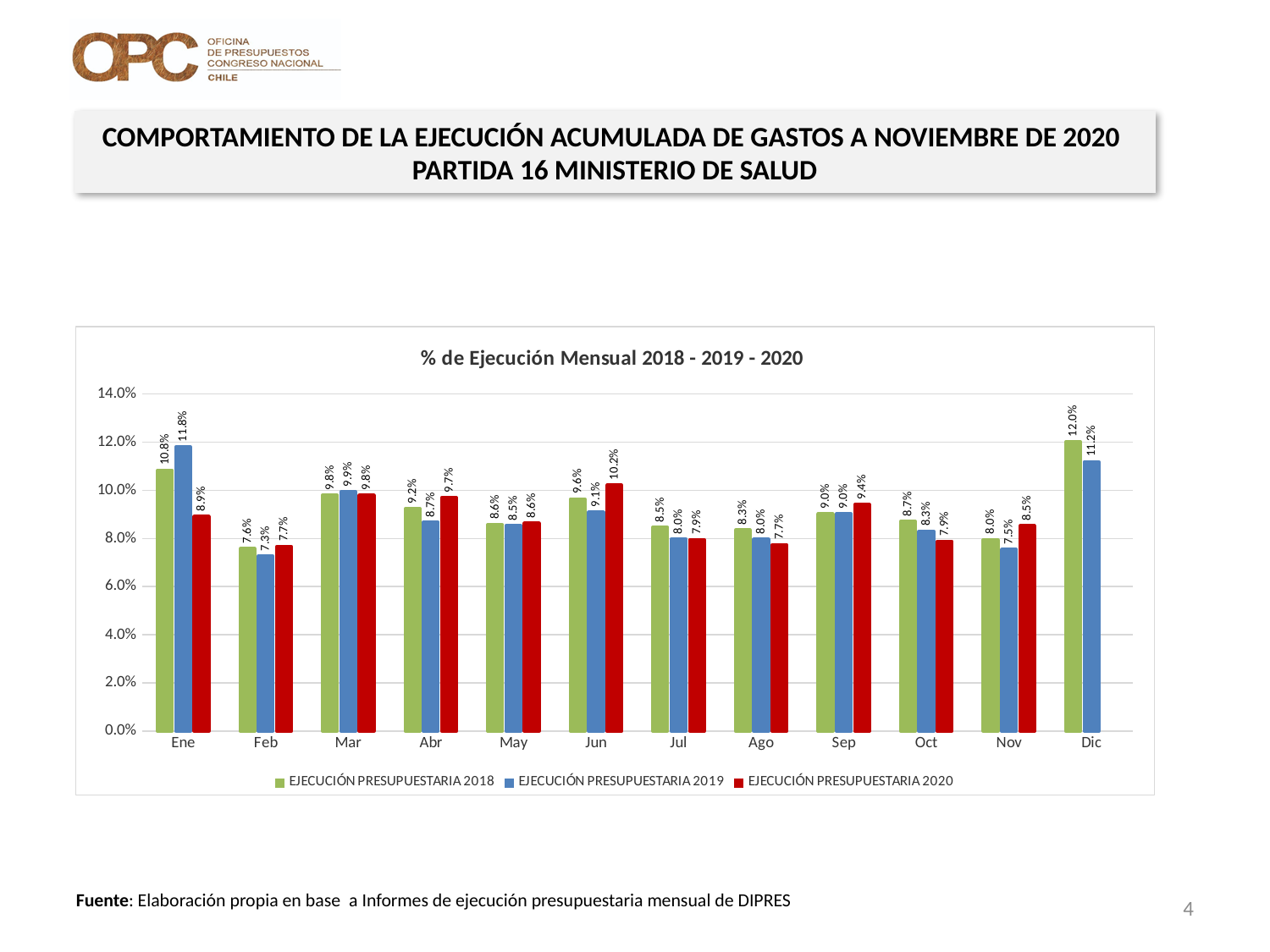
What is the title of the chart? % de Ejecución Mensual 2018 - 2019 - 2020 Which month has the lowest value for EJECUCIÓN PRESUPUESTARIA 2019? Feb What is the value for EJECUCIÓN PRESUPUESTARIA 2018 in Dic? 12.0% What is the value for EJECUCIÓN PRESUPUESTARIA 2019 in Ene? 11.8% Which is larger in Nov: EJECUCIÓN PRESUPUESTARIA 2018 or EJECUCIÓN PRESUPUESTARIA 2020? EJECUCIÓN PRESUPUESTARIA 2020 Which month has the highest value for EJECUCIÓN PRESUPUESTARIA 2020? Jun How many series does the legend list? 3 What is the difference between the EJECUCIÓN PRESUPUESTARIA 2019 and EJECUCIÓN PRESUPUESTARIA 2020 values in Ene? 2.9% Is the value for EJECUCIÓN PRESUPUESTARIA 2018 in Ene greater or less than 10.0%? greater How many months are shown on the x axis? 12 What is the value for EJECUCIÓN PRESUPUESTARIA 2020 in Jun? 10.2% What kind of chart is shown? Bar chart